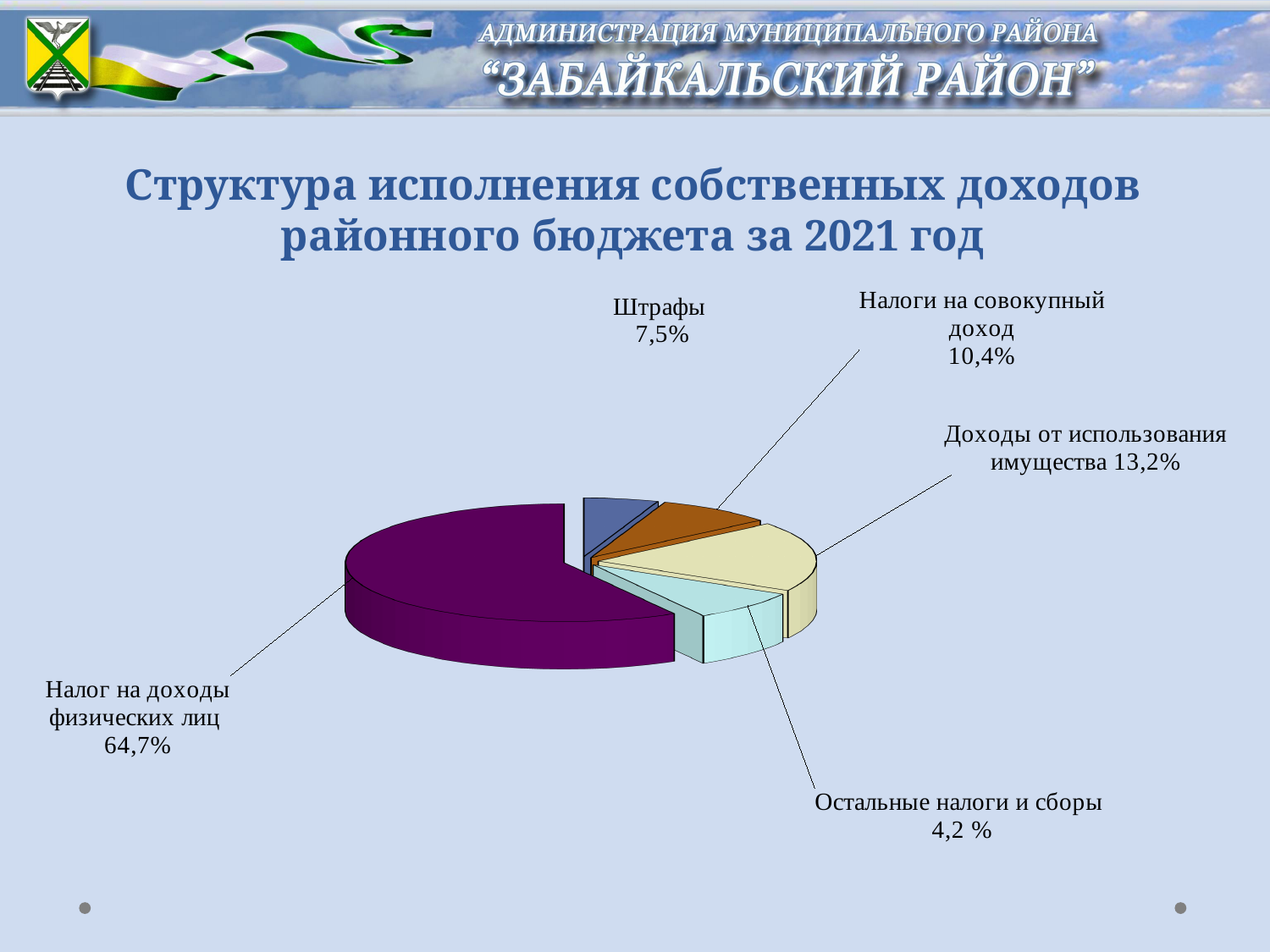
What is the share of Налоги на совокупный доход? 10,4% What is the title of the chart on the slide? Структура исполнения собственных доходов районного бюджета за 2021 год What is the share of Налог на доходы физических лиц in the pie chart? 64,7% What is the share of Штрафы in the pie chart? 7,5% Which category has the smallest slice of the pie chart? Остальные налоги и сборы Which category has the largest slice of the pie chart? Налог на доходы физических лиц What is the share of Доходы от использования имущества? 13,2% Which is larger: the share of Штрафы or the share of Налоги на совокупный доход? Налоги на совокупный доход How many slices does the pie chart have? 5 What is the difference in percentage points between Доходы от использования имущества and Налоги на совокупный доход? 2,8 What is the share of Остальные налоги и сборы? 4,2 % What kind of chart is shown on the slide? Pie chart